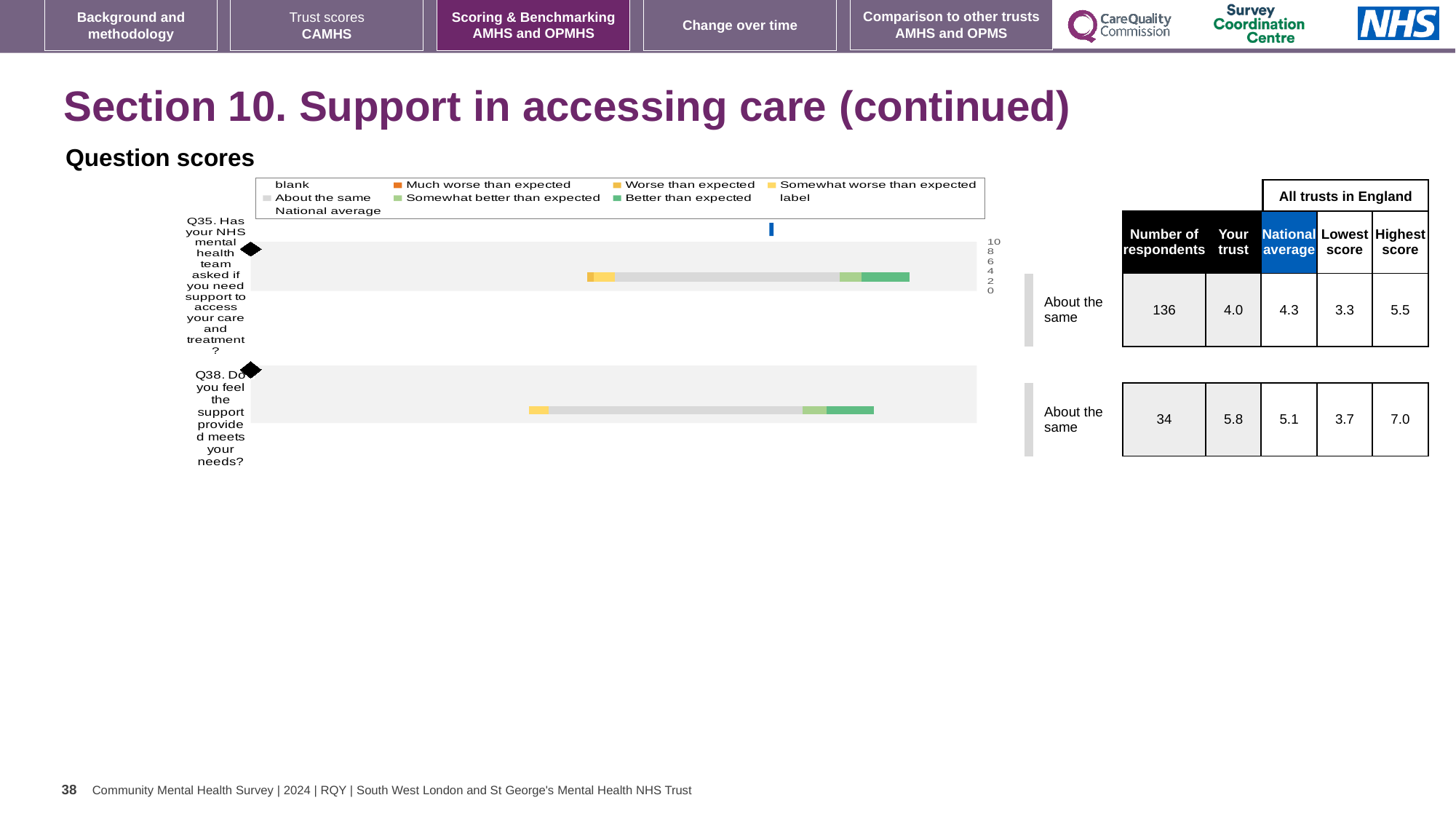
For Q35, how much higher is the national average than the 'Your trust' score? 0.3 What kind of chart is used to show the question scores on this slide? bar chart What is the 'Your trust' score for Q35 (Has your NHS mental health team asked if you need support to access your care and treatment?)? 4.0 What benchmark category is shown for Q35? About the same What is the lowest score across all trusts in England for Q38? 3.7 What is the national average score for Q38 (Do you feel the support provided meets your needs?)? 5.1 For Q38, which is larger: the 'Your trust' score or the national average? Your trust How many questions are plotted in the question scores chart? 2 What is the difference between the highest score and the lowest score for Q38? 3.3 Which question has the higher 'Your trust' score, Q35 or Q38? Q38 How many respondents answered Q35? 136 What is the highest score across all trusts in England for Q35? 5.5